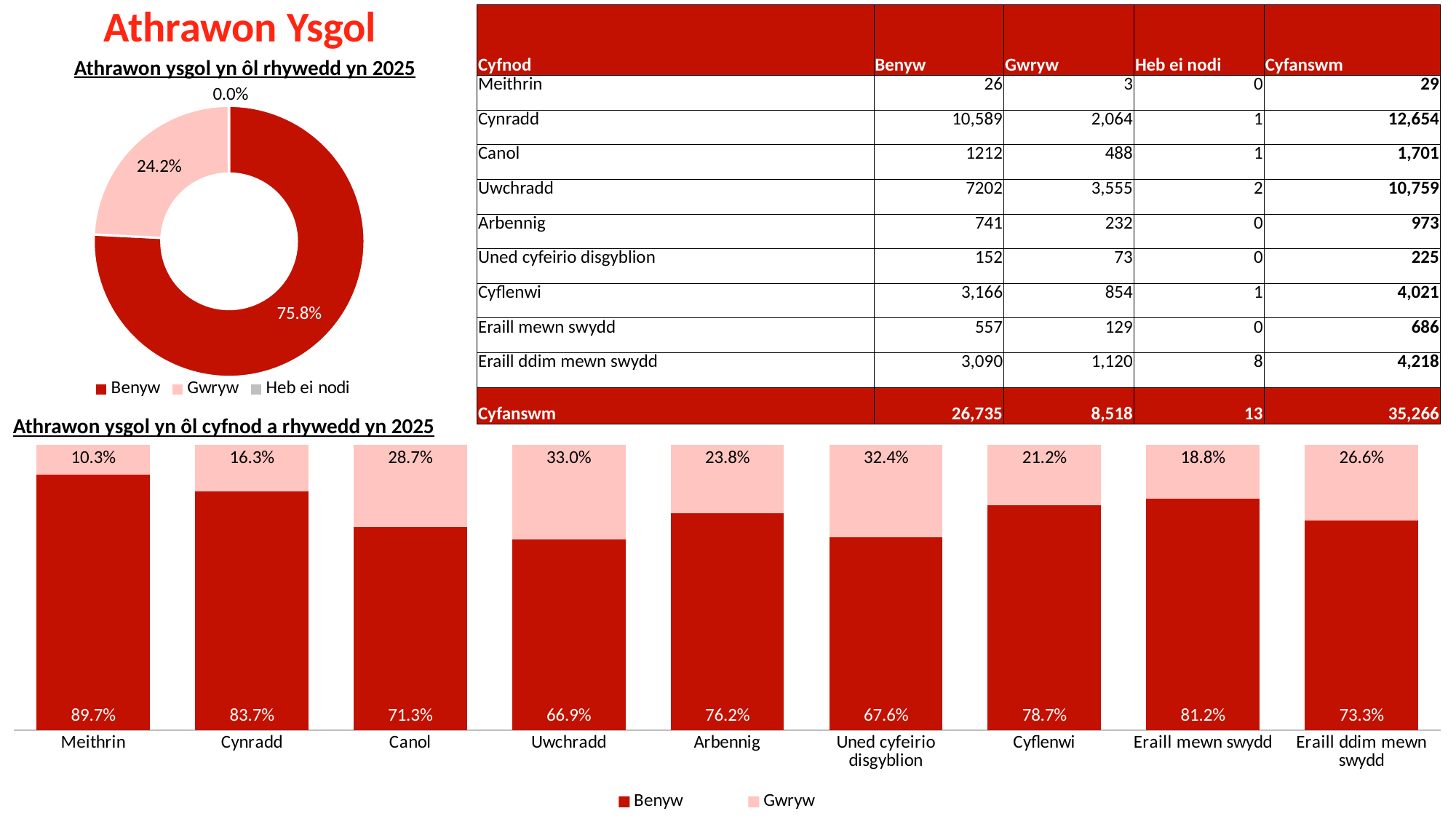
In the chart 'Athrawon ysgol yn ôl cyfnod a rhywedd yn 2025', what is the Gwryw value for Uwchradd? 33.0% In the chart 'Athrawon ysgol yn ôl cyfnod a rhywedd yn 2025', what is the difference between the Benyw values for Meithrin and Cynradd? 6.0% In the chart 'Athrawon ysgol yn ôl cyfnod a rhywedd yn 2025', which category has the lowest Benyw value? Uwchradd In the chart 'Athrawon ysgol yn ôl cyfnod a rhywedd yn 2025', which category has the highest Gwryw value? Uwchradd In the chart 'Athrawon ysgol yn ôl cyfnod a rhywedd yn 2025', what is the Benyw value for Meithrin? 89.7% In the chart 'Athrawon ysgol yn ôl rhywedd yn 2025', what share of the pie is Benyw? 75.8% What kind of chart is 'Athrawon ysgol yn ôl rhywedd yn 2025'? Doughnut (pie) chart In the chart 'Athrawon ysgol yn ôl cyfnod a rhywedd yn 2025', which is larger: the Gwryw value for Canol or for Arbennig? Canol How many categories are shown on the x axis of the chart 'Athrawon ysgol yn ôl cyfnod a rhywedd yn 2025'? 9 In the chart 'Athrawon ysgol yn ôl rhywedd yn 2025', what share of the pie is Gwryw? 24.2% In the chart 'Athrawon ysgol yn ôl rhywedd yn 2025', how many entries does the legend list? 3 What kind of chart is 'Athrawon ysgol yn ôl cyfnod a rhywedd yn 2025'? Stacked bar chart